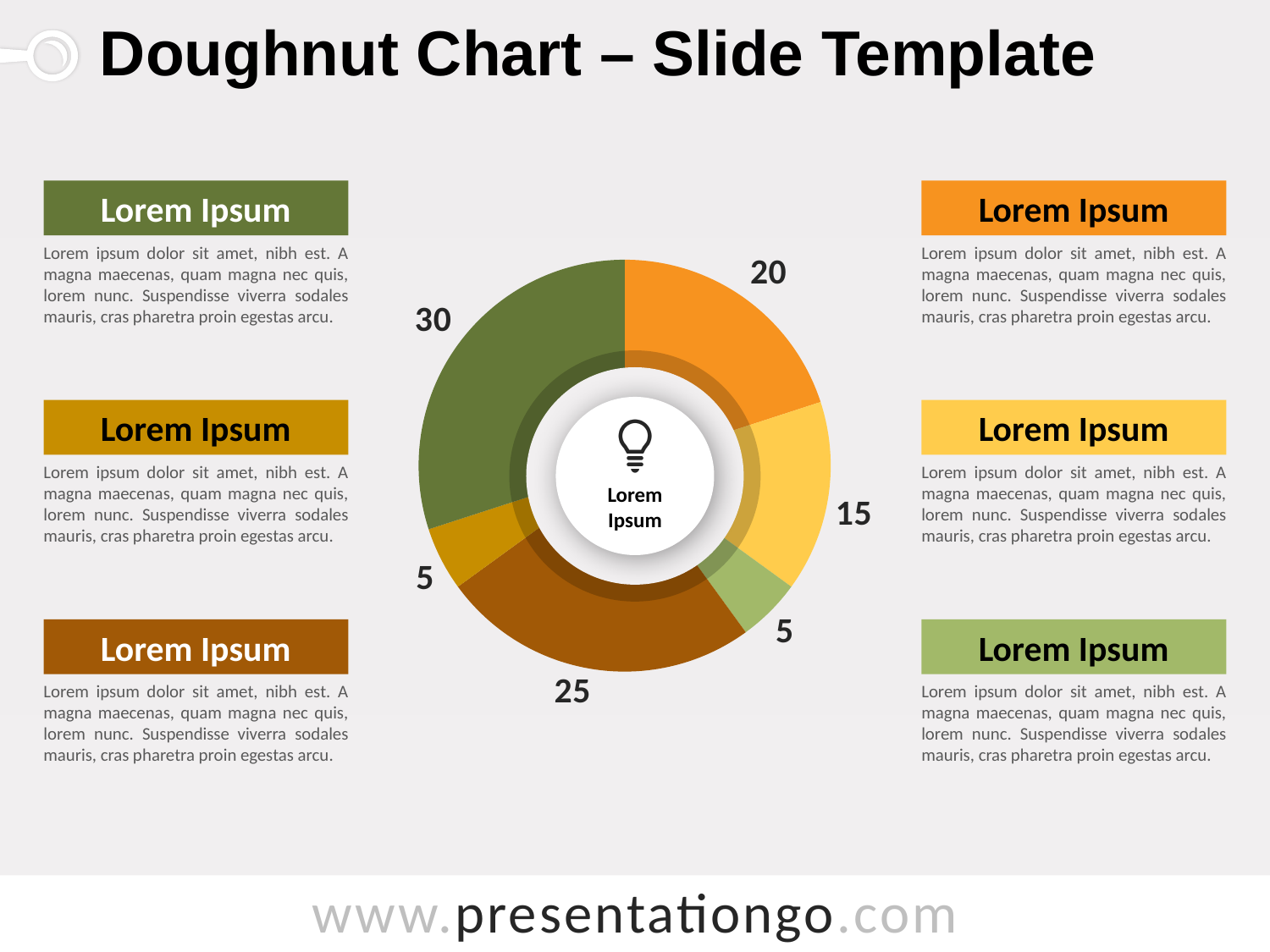
How many slices does the doughnut chart have? 6 What is the smallest value shown on the doughnut chart? 5 What is the largest value shown on the doughnut chart? 30 What is the value of the brown slice of the doughnut chart? 25 What is the value of the yellow slice of the doughnut chart? 15 What is the value of the orange slice of the doughnut chart? 20 What is the value of the dark green slice of the doughnut chart? 30 Which is larger, the orange slice (20) or the yellow slice (15)? The orange slice (20) What is the difference between the largest slice value (30) and the brown slice value (25)? 5 What kind of chart is shown on the slide? Doughnut chart What is the total of all the values shown on the doughnut chart? 100 What is the title of the slide? Doughnut Chart – Slide Template